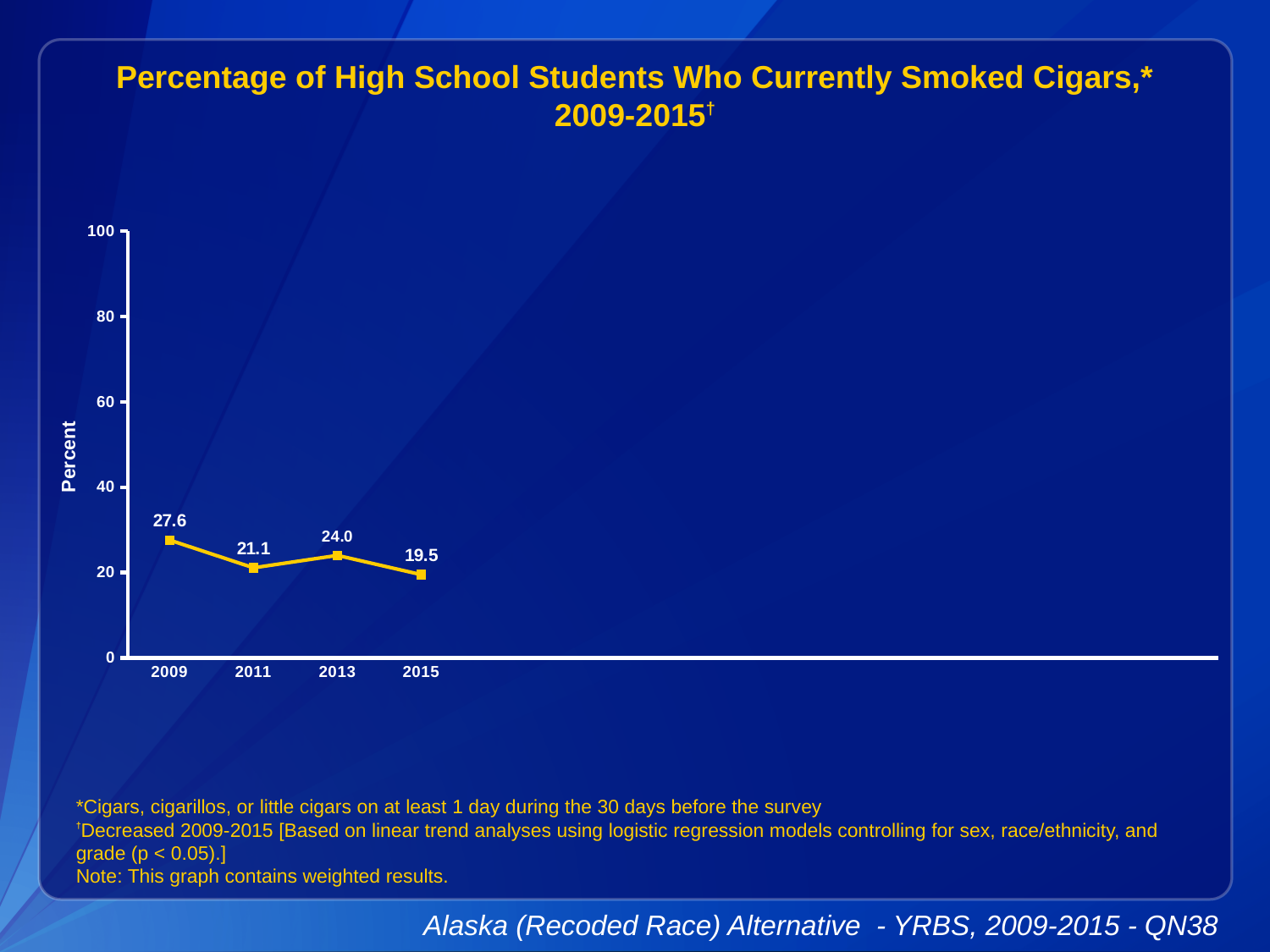
How many years are plotted on the chart? 4 What is the value plotted for 2013? 24.0 Which year has the highest percentage? 2009 What is the value plotted for 2015? 19.5 What is the label on the y axis? Percent What kind of chart is shown on the slide? line chart Which year has the lowest percentage? 2015 What is the difference between the 2009 value and the 2015 value? 8.1 What percentage of high school students currently smoked cigars in 2009? 27.6 Is the value for 2015 greater or less than 20? less Which year has the larger value, 2011 or 2013? 2013 What is the value plotted for 2011? 21.1